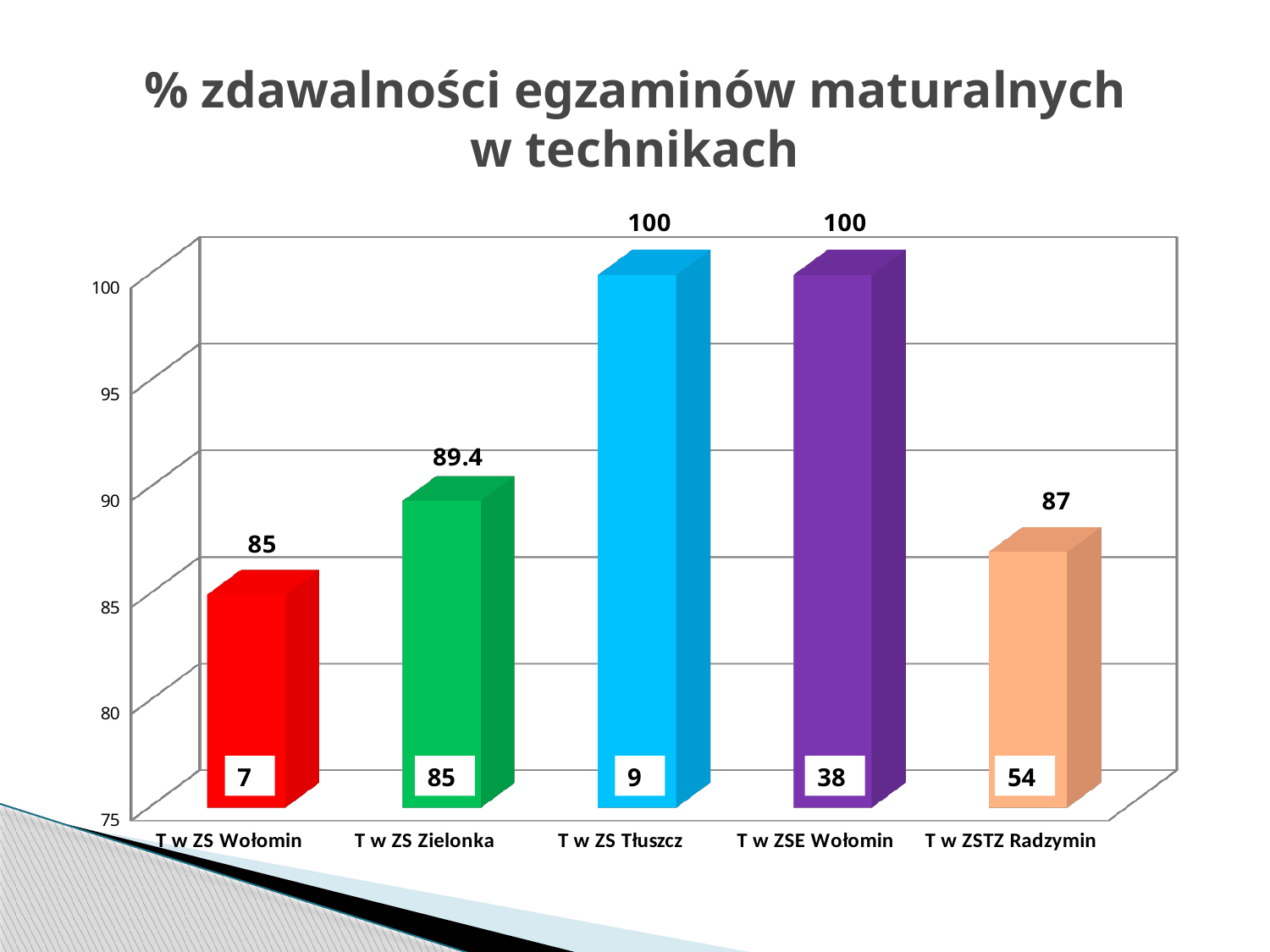
What is the difference between the values for T w ZSE Wołomin and T w ZSTZ Radzymin? 13 What is the highest value shown on the chart? 100 Is the value for T w ZS Zielonka greater or less than 90? less Which category has the lowest value? T w ZS Wołomin Which is larger, the value for T w ZSTZ Radzymin or the value for T w ZS Wołomin? T w ZSTZ Radzymin What is the value for T w ZS Zielonka? 89.4 How many categories are shown on the chart? 5 What is the value for T w ZS Tłuszcz? 100 What is the value for T w ZSTZ Radzymin? 87 What kind of chart is shown on the slide? bar chart What is the difference between the values for T w ZS Zielonka and T w ZS Wołomin? 4.4 What is the title of the chart? % zdawalności egzaminów maturalnych w technikach